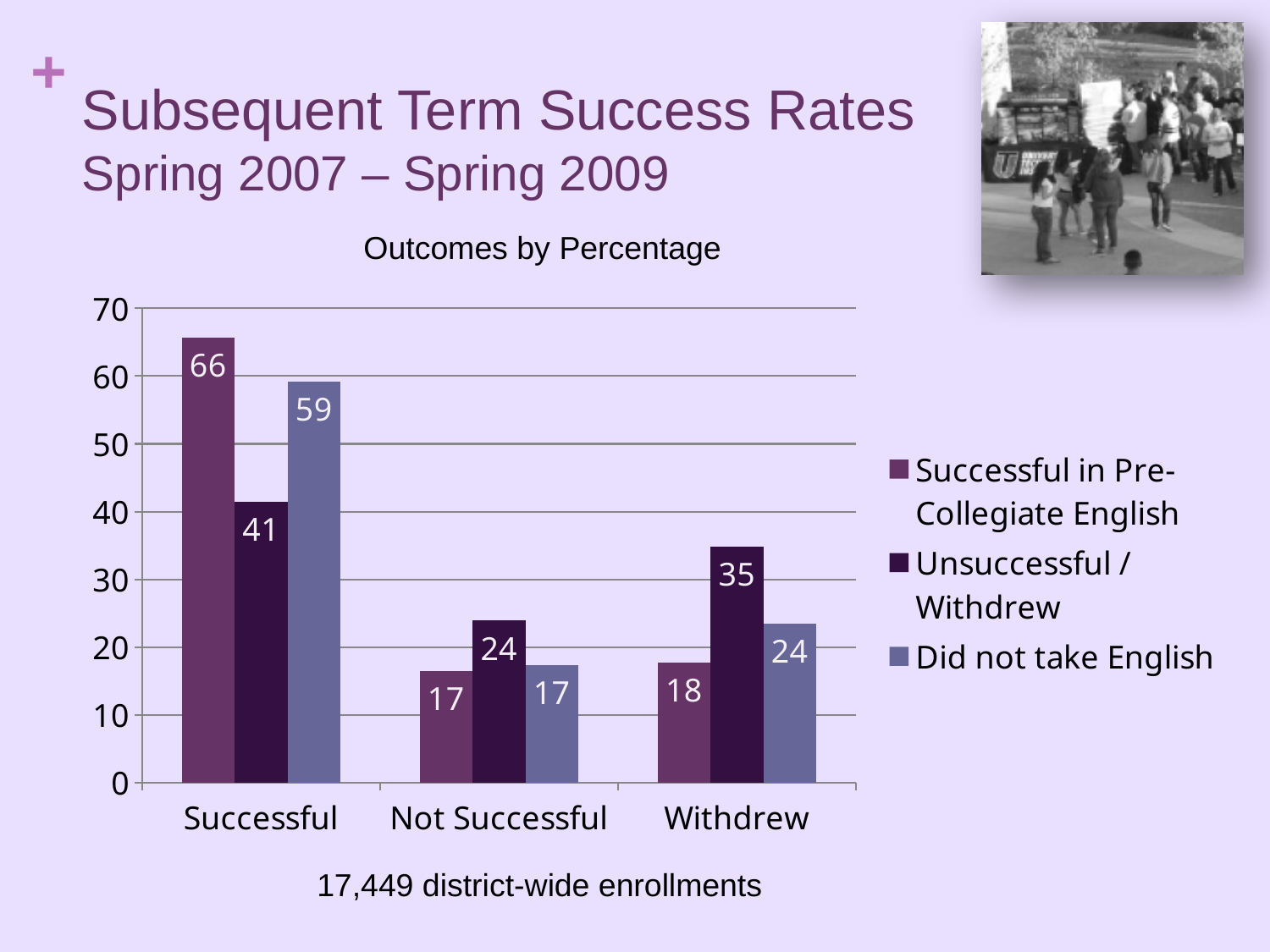
Which is larger in the Withdrew category: 'Unsuccessful / Withdrew' or 'Did not take English'? Unsuccessful / Withdrew How many categories are shown on the x axis? 3 Which series has the highest value in the Successful category? Successful in Pre-Collegiate English Is the value for 'Did not take English' in the Successful category greater or less than 50? greater What is the difference between the 'Successful in Pre-Collegiate English' and 'Unsuccessful / Withdrew' values in the Successful category? 25 What is the value for 'Did not take English' in the Withdrew category? 24 What kind of chart is shown on the slide? bar chart What is the value for 'Unsuccessful / Withdrew' in the Not Successful category? 24 What is the title of the chart? Outcomes by Percentage Which series has the lowest value in the Withdrew category? Successful in Pre-Collegiate English How many series does the legend list? 3 What is the value for 'Successful in Pre-Collegiate English' in the Successful category? 66